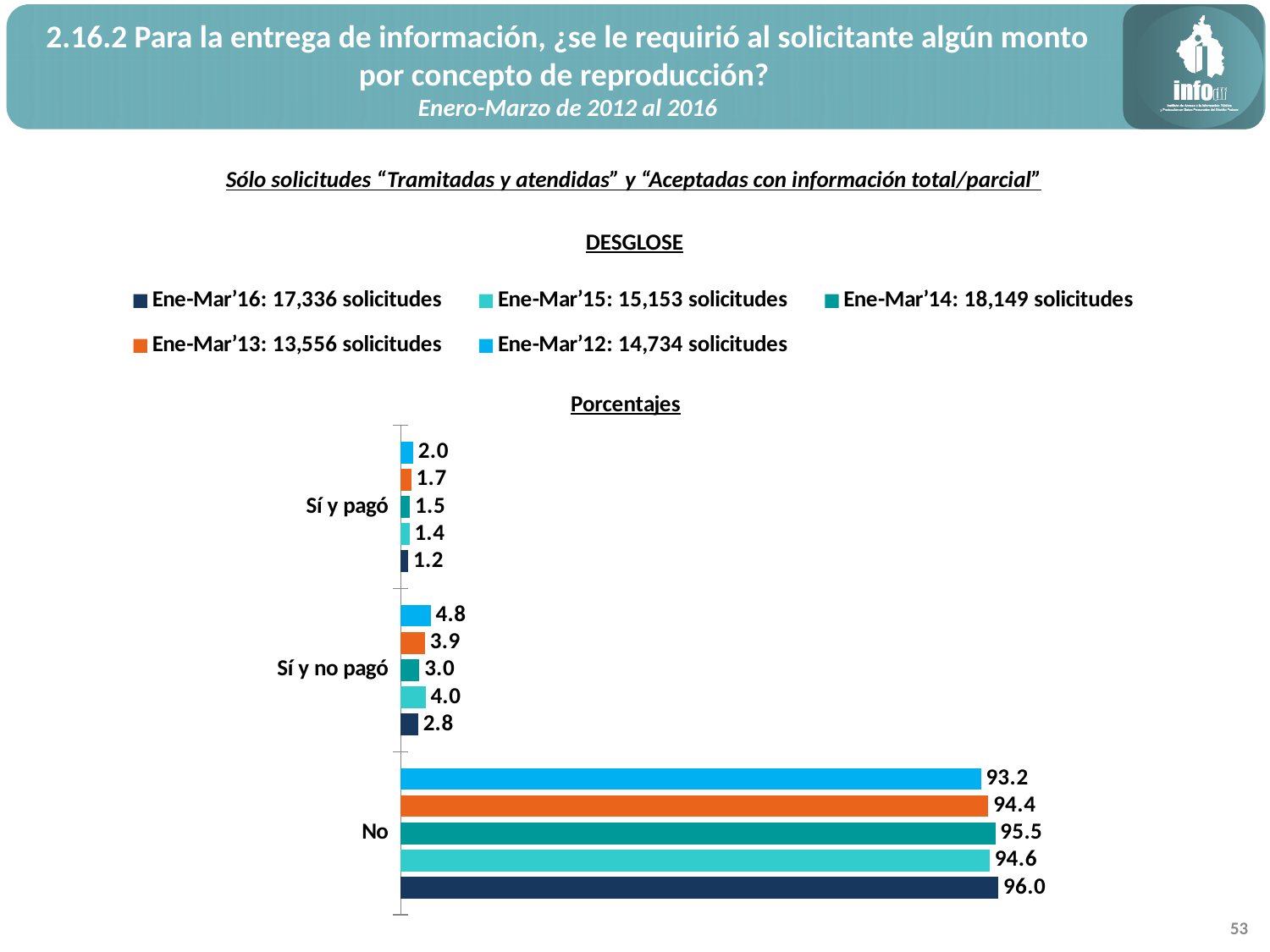
What is the difference between the Ene-Mar'12 and Ene-Mar'16 values in the "Sí y no pagó" category? 2.0 How many categories are shown on the chart? 3 Which period has the lowest value in the "Sí y pagó" category? Ene-Mar'16 How many series does the legend list? 5 In the "Sí y no pagó" category, which is larger: the value for Ene-Mar'13 or Ene-Mar'14? Ene-Mar'13 Which period has the highest value in the "No" category? Ene-Mar'16 According to the legend, how many solicitudes were there in Ene-Mar'14? 18,149 solicitudes What is the value for Ene-Mar'12 in the "Sí y pagó" category? 2.0 What is the value for Ene-Mar'16 in the "No" category? 96.0 What is the value for Ene-Mar'15 in the "Sí y no pagó" category? 4.0 What kind of chart is shown on the slide? Bar chart What is the value for Ene-Mar'13 in the "No" category? 94.4